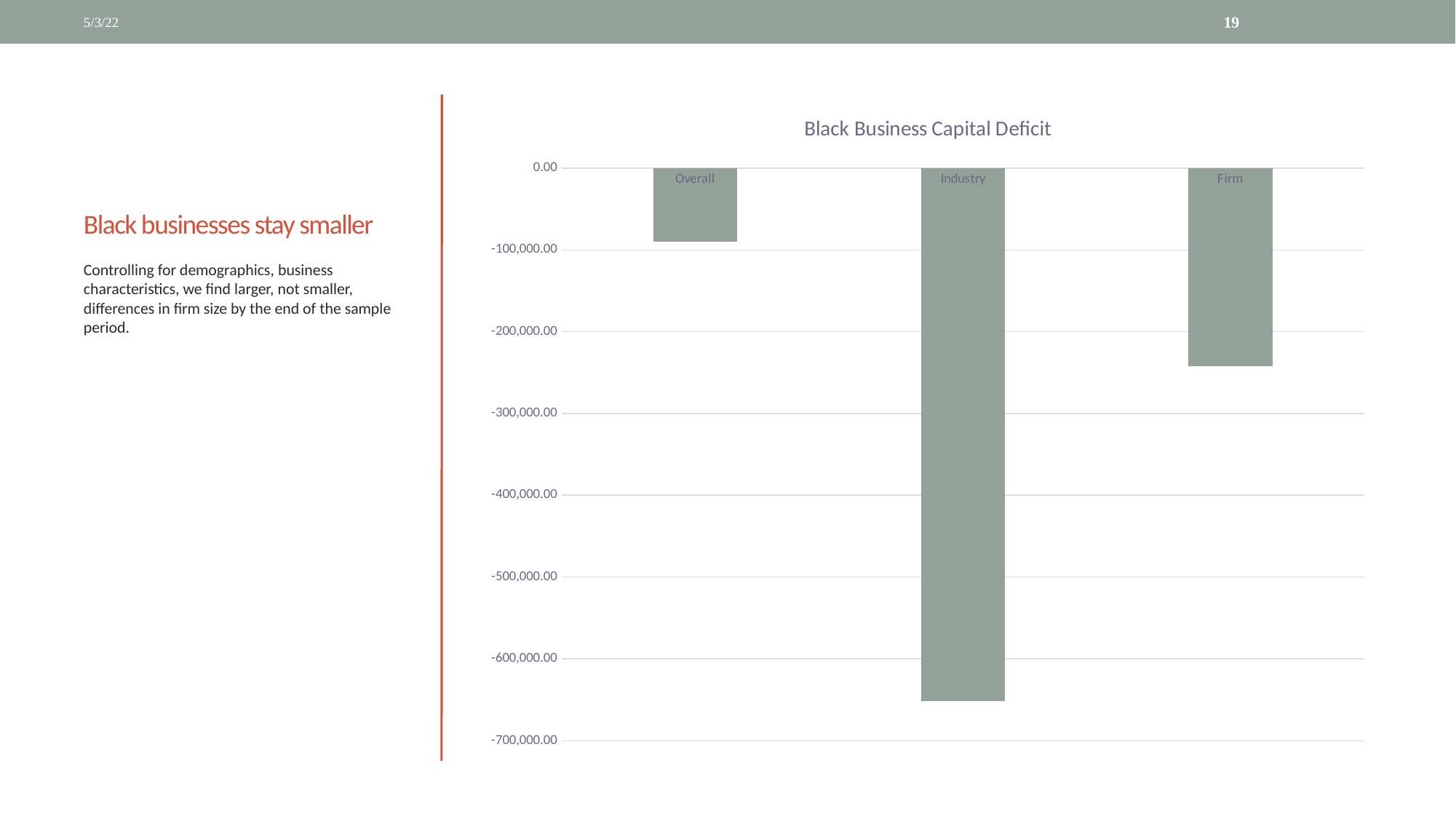
Which category has the highest value (closest to zero) in the chart? Overall Is the value for Firm greater or less than -200,000.00? less How many categories are plotted in the chart? 3 Is the value for Overall greater or less than -100,000.00? greater Which value is larger (closer to zero), Industry or Firm? Firm What kind of chart is shown on the slide? bar chart Is the value for Industry greater or less than -600,000.00? less What is the title of the chart? Black Business Capital Deficit What is the lowest value shown on the vertical axis of the chart? -700,000.00 Which bar extends furthest below zero, Firm or Overall? Firm Which category has the lowest (most negative) value in the chart? Industry